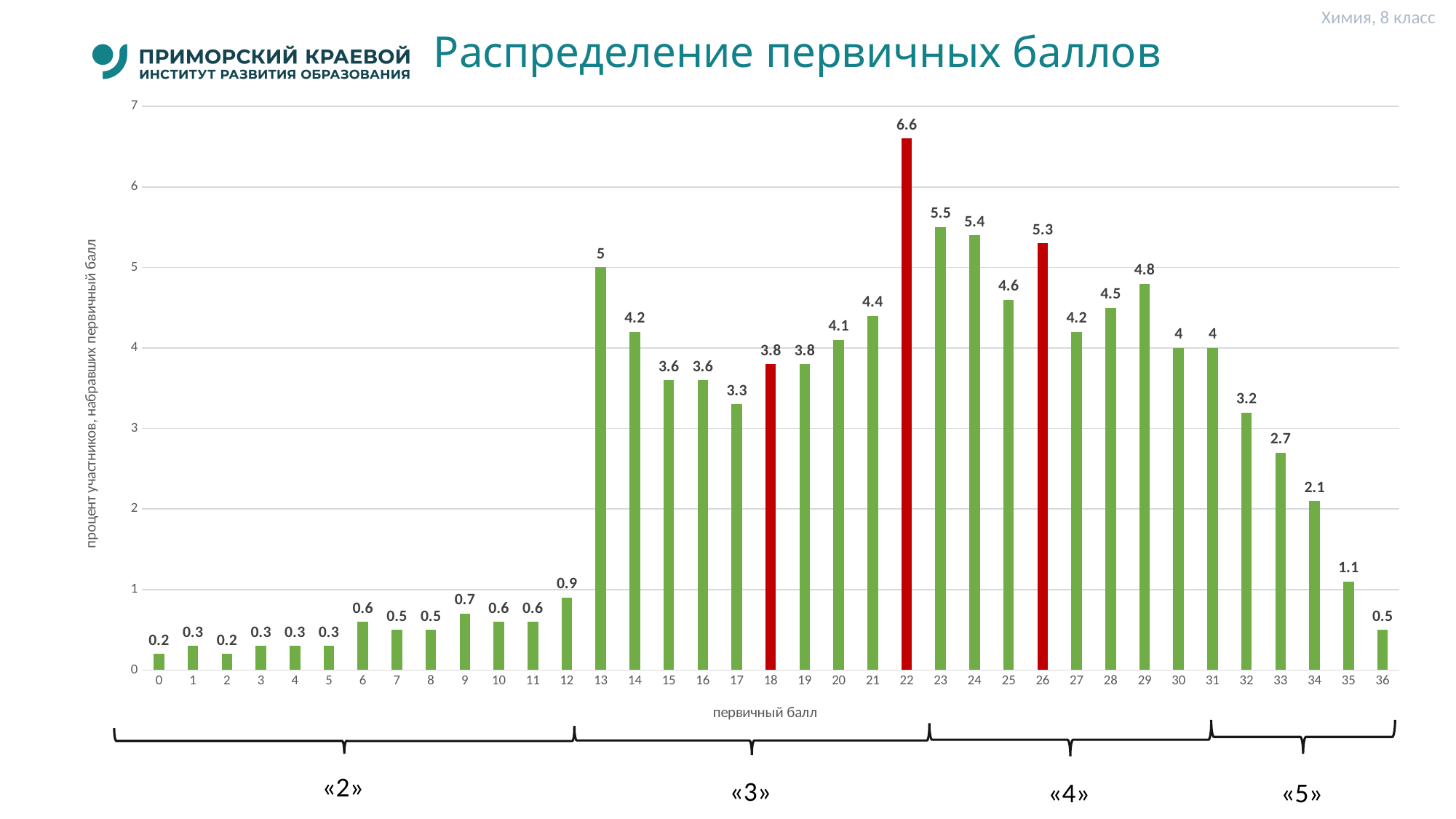
What is the difference between the values for primary scores 23 and 24? 0.1 What is the value for primary score 22? 6.6 Is the value for primary score 32 greater or less than 3? greater What is the value for primary score 13? 5 What type of chart is shown on the slide? bar chart Which primary score has the highest value? 22 How many primary score categories are shown on the x axis? 37 What is the title of the chart? Распределение первичных баллов What is the value for primary score 34? 2.1 Do the values rise or fall from primary score 31 to primary score 36? fall What is the difference between the values for primary scores 22 and 26? 1.3 Which is larger, the value for primary score 29 or the value for primary score 30? 29